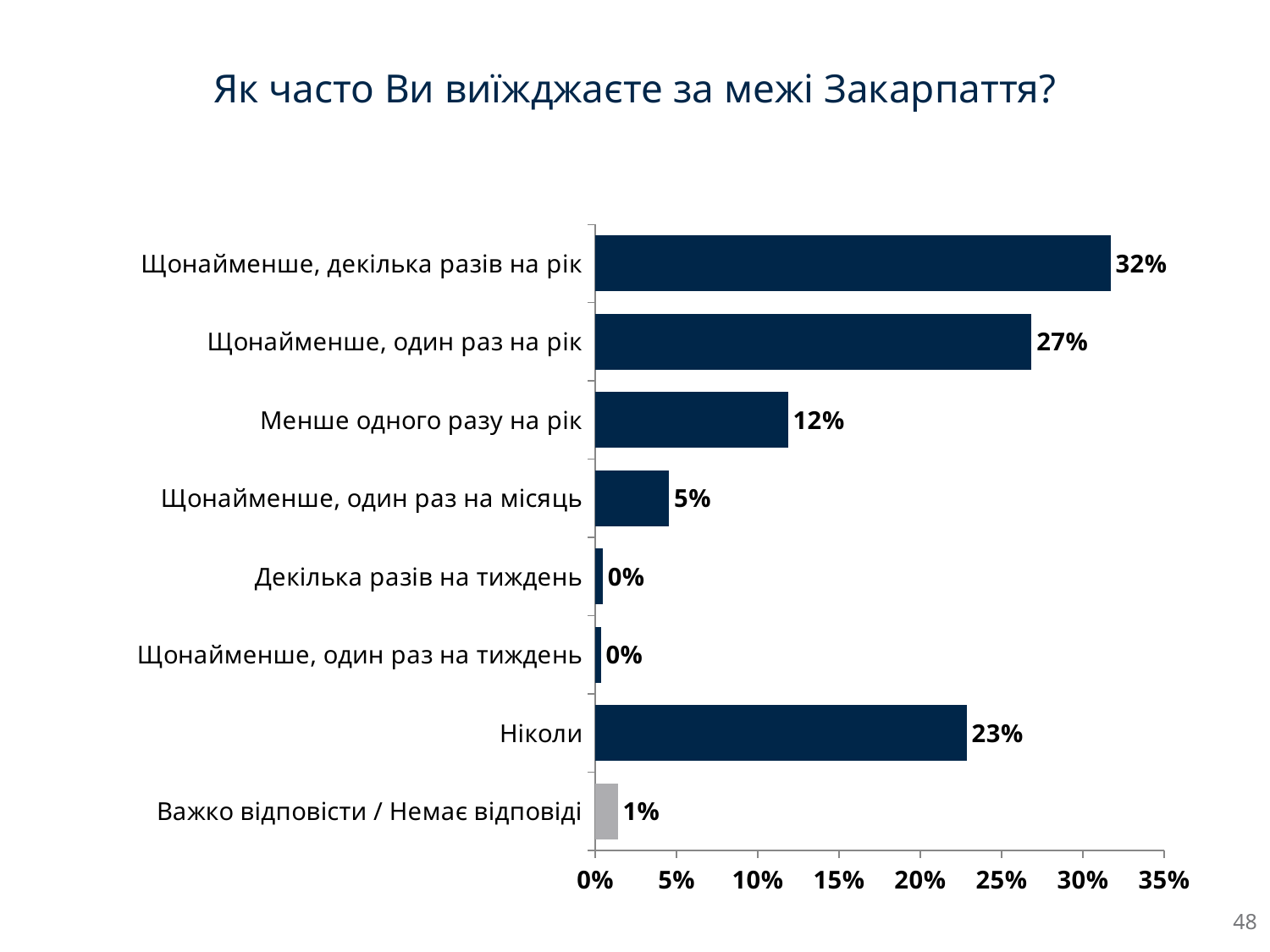
Which category has the highest value? Щонайменше, декілька разів на рік Is the value for "Щонайменше, один раз на місяць" greater or less than 10%? less What is the title of the chart? Як часто Ви виїжджаєте за межі Закарпаття? What is the value for "Ніколи"? 23% What is the value for "Важко відповісти / Немає відповіді"? 1% Which is larger: "Щонайменше, один раз на рік" or "Ніколи"? Щонайменше, один раз на рік What is the difference between "Ніколи" and "Менше одного разу на рік"? 11% What is the difference between "Щонайменше, декілька разів на рік" and "Щонайменше, один раз на рік"? 5% What type of chart is shown on the slide? bar chart What is the value for "Менше одного разу на рік"? 12% How many categories are shown in the chart? 8 What is the value for "Щонайменше, декілька разів на рік"? 32%